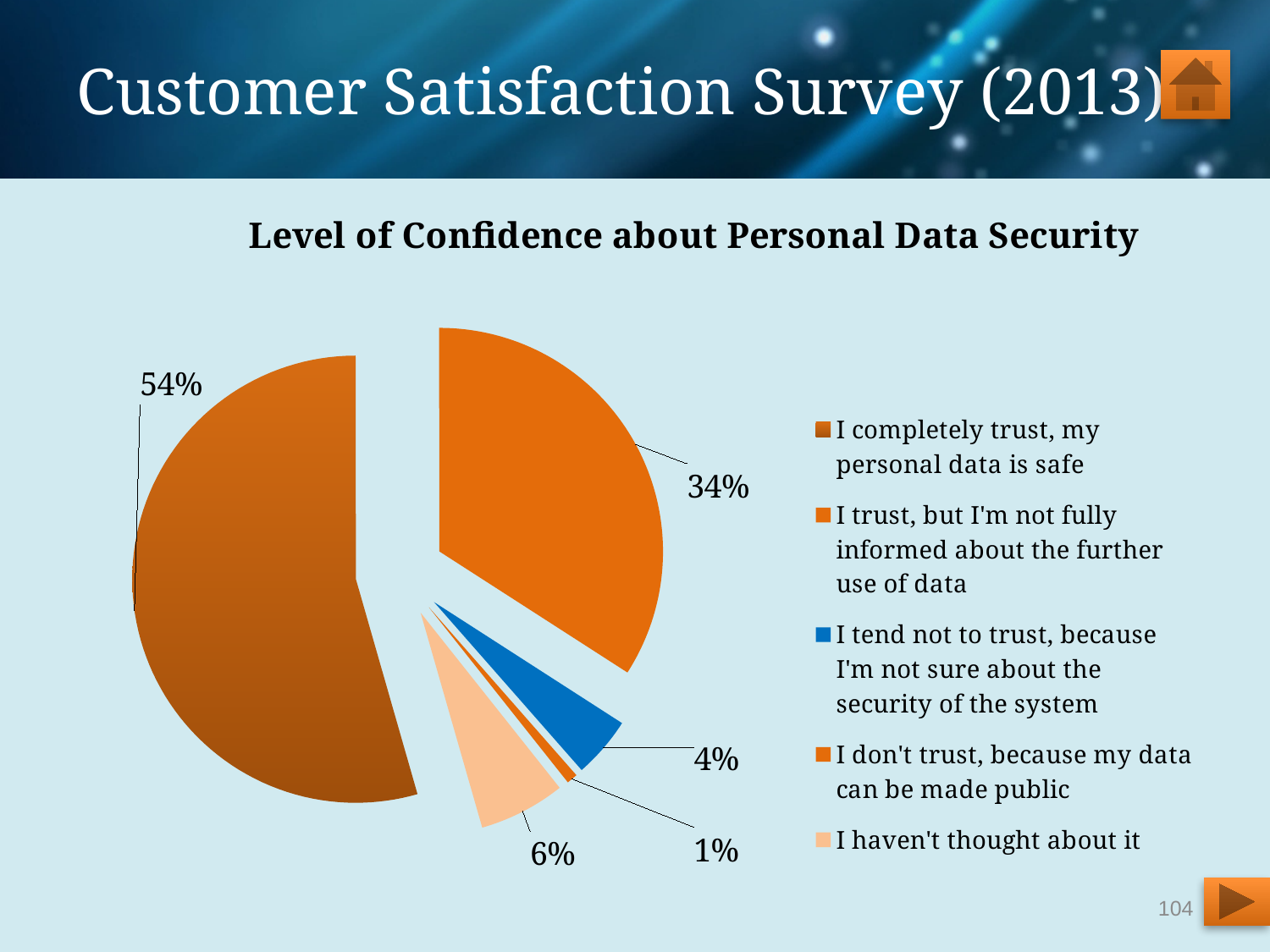
What share of respondents said "I completely trust, my personal data is safe"? 54% What share of respondents said "I trust, but I'm not fully informed about the further use of data"? 34% Which is larger: the share for "I haven't thought about it" or the share for "I tend not to trust, because I'm not sure about the security of the system"? I haven't thought about it What is the difference in percentage points between "I completely trust, my personal data is safe" and "I trust, but I'm not fully informed about the further use of data"? 20 percentage points What is the title of the chart? Level of Confidence about Personal Data Security Which response has the smallest share of the pie? I don't trust, because my data can be made public How many slices does the pie chart have? 5 What share of respondents said "I haven't thought about it"? 6% Which response has the largest share of the pie? I completely trust, my personal data is safe What kind of chart is shown on the slide? pie chart